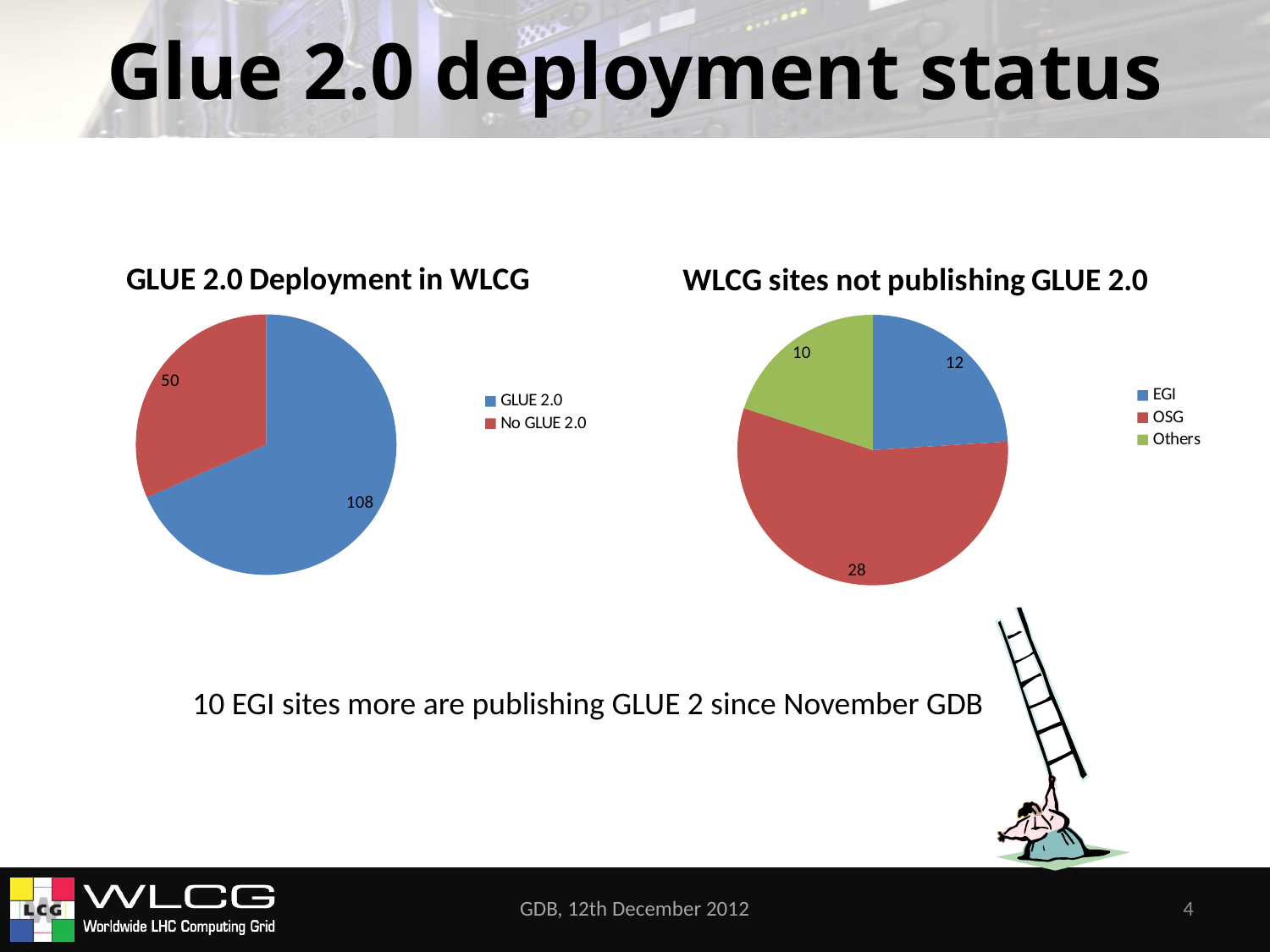
In the 'WLCG sites not publishing GLUE 2.0' chart, which is larger, EGI or Others? EGI What type of chart is 'GLUE 2.0 Deployment in WLCG'? Pie chart In the 'WLCG sites not publishing GLUE 2.0' chart, which category has the largest slice? OSG In the 'GLUE 2.0 Deployment in WLCG' chart, what is the value for No GLUE 2.0? 50 In the 'GLUE 2.0 Deployment in WLCG' chart, what is the value for GLUE 2.0? 108 In the 'WLCG sites not publishing GLUE 2.0' chart, what share of the pie does OSG represent? 56% In the 'WLCG sites not publishing GLUE 2.0' chart, what is the value for EGI? 12 How many categories does the 'WLCG sites not publishing GLUE 2.0' chart show? 3 In the 'WLCG sites not publishing GLUE 2.0' chart, which category has the smallest slice? Others In the 'WLCG sites not publishing GLUE 2.0' chart, what is the value for OSG? 28 In the 'GLUE 2.0 Deployment in WLCG' chart, what is the difference between the GLUE 2.0 and No GLUE 2.0 values? 58 In the 'WLCG sites not publishing GLUE 2.0' chart, what is the difference between the OSG and EGI values? 16